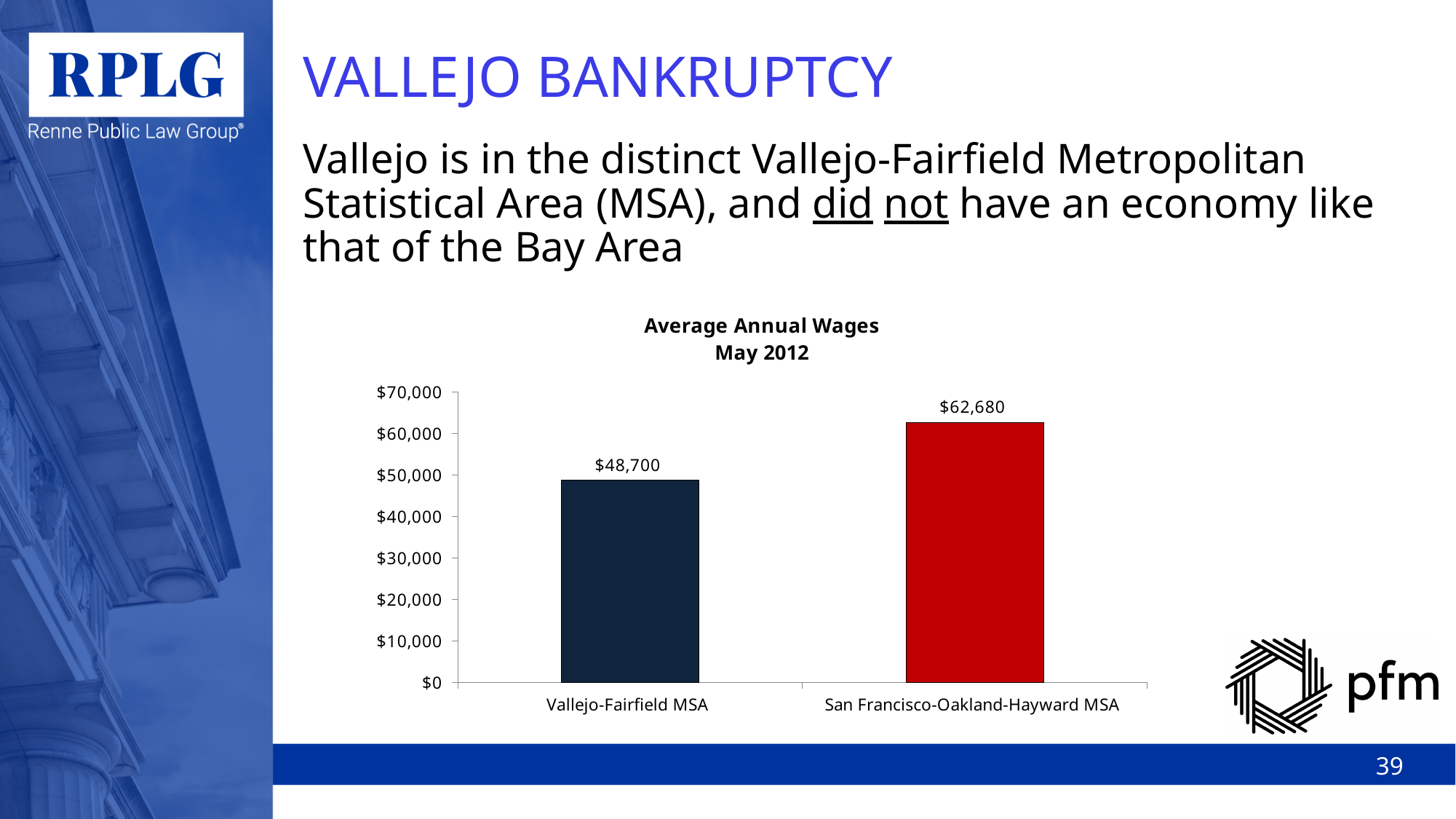
How many MSAs are shown in the chart? 2 What is the average annual wage for the Vallejo-Fairfield MSA? $48,700 Is the average annual wage higher in the Vallejo-Fairfield MSA or the San Francisco-Oakland-Hayward MSA? San Francisco-Oakland-Hayward MSA What is the title of the chart? Average Annual Wages May 2012 Is the average annual wage for the Vallejo-Fairfield MSA greater or less than $50,000? less What type of chart is shown on the slide? Bar chart What is the average annual wage for the San Francisco-Oakland-Hayward MSA? $62,680 Which MSA has the higher average annual wage? San Francisco-Oakland-Hayward MSA Is the average annual wage for the San Francisco-Oakland-Hayward MSA greater or less than $60,000? greater What colour is the bar for the San Francisco-Oakland-Hayward MSA? Red What is the difference between the average annual wages of the San Francisco-Oakland-Hayward MSA and the Vallejo-Fairfield MSA? $13,980 Which MSA has the lower average annual wage? Vallejo-Fairfield MSA